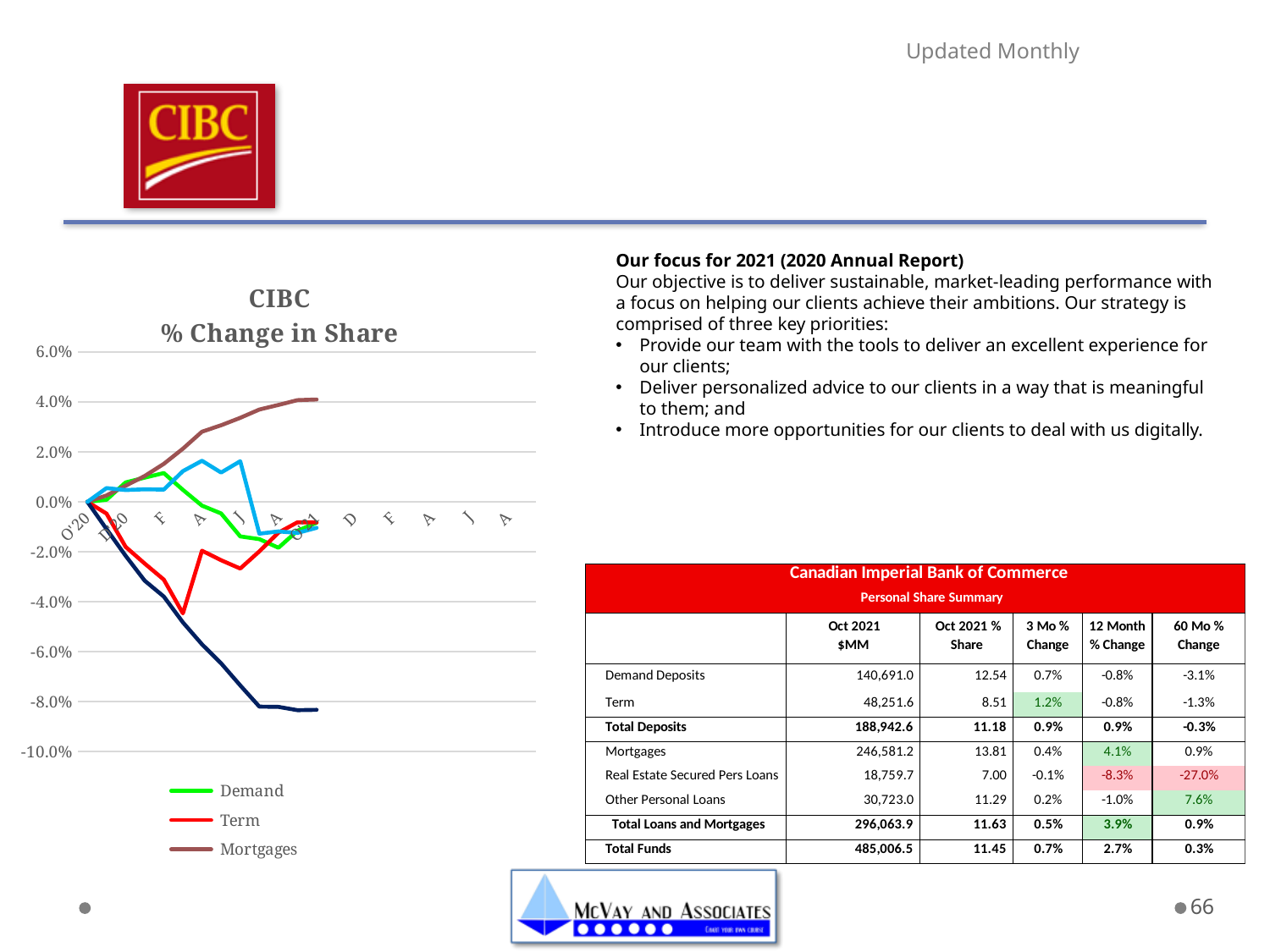
What kind of chart is shown on the slide? line chart Is the final value of the Mortgages line greater or less than 2.0%? greater Does the Mortgages line generally rise or fall along the x axis? rise How many series does the chart legend list? 3 What is the title of the chart? CIBC % Change in Share Of the series listed in the legend, which one ends at the highest value? Mortgages Is the highest point of the Demand line greater or less than 2.0%? less Which series is shown in green in the chart legend? Demand Of the series listed in the legend, which one reaches the lowest value on the chart? Term Is the lowest point of the Term line greater or less than -2.0%? less At the end of the plotted period, which is larger: the Mortgages value or the Term value? Mortgages